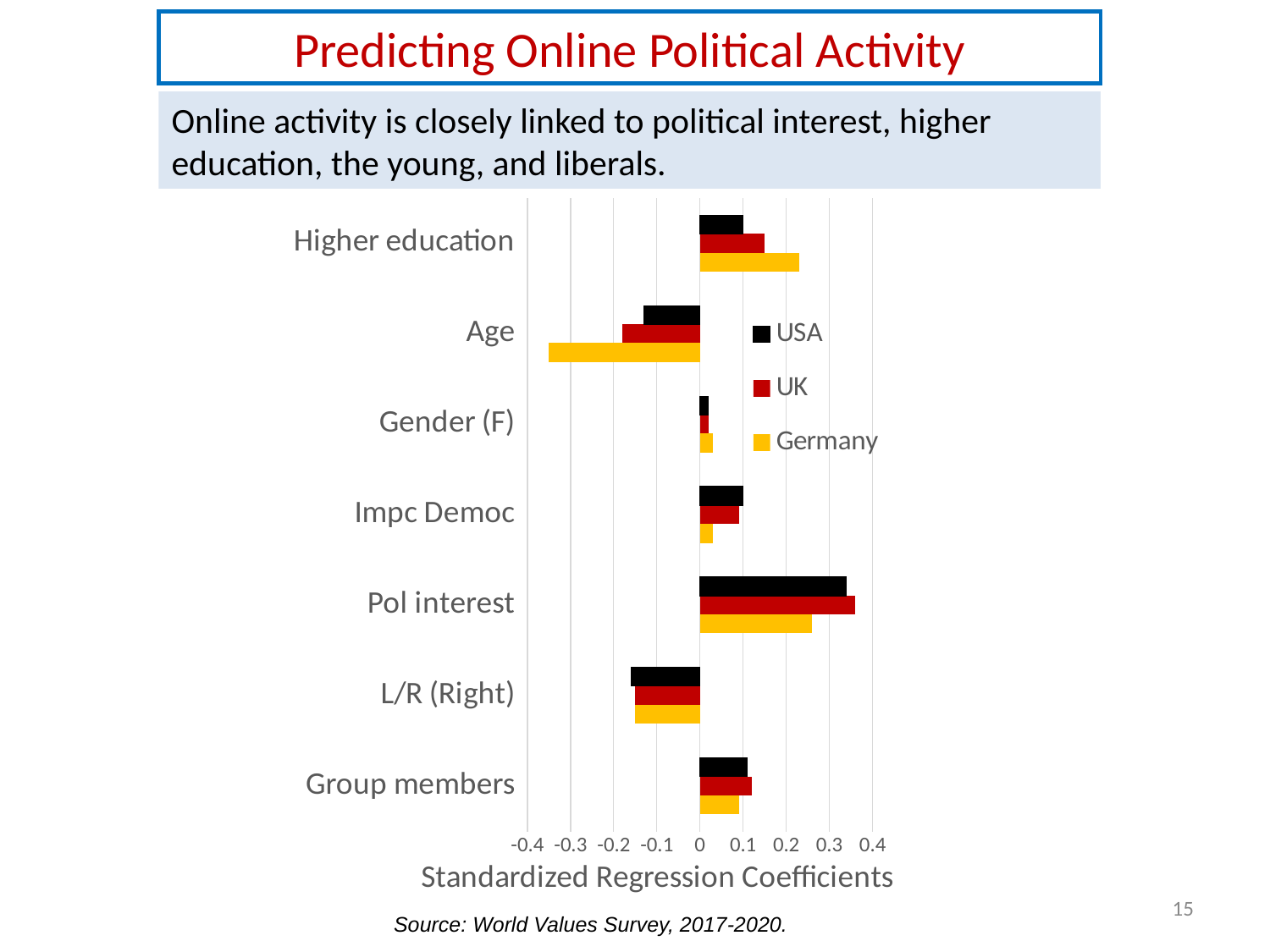
What kind of chart is shown on the slide? bar chart For Higher education, which series has the highest value? Germany For Age, which series has the lowest (most negative) value? Germany Is the USA value for Pol interest greater or less than 0.3? greater Is the Germany value for Impc Democ greater or less than 0.1? less How many categories are plotted on the chart? 7 For Higher education, which is larger: the USA value or the Germany value? Germany How many series does the legend list? 3 For Pol interest, which is larger: the UK value or the Germany value? UK Is the Germany value for Age greater or less than -0.3? less What is the title of the horizontal axis? Standardized Regression Coefficients Which category has the highest value for the USA series? Pol interest